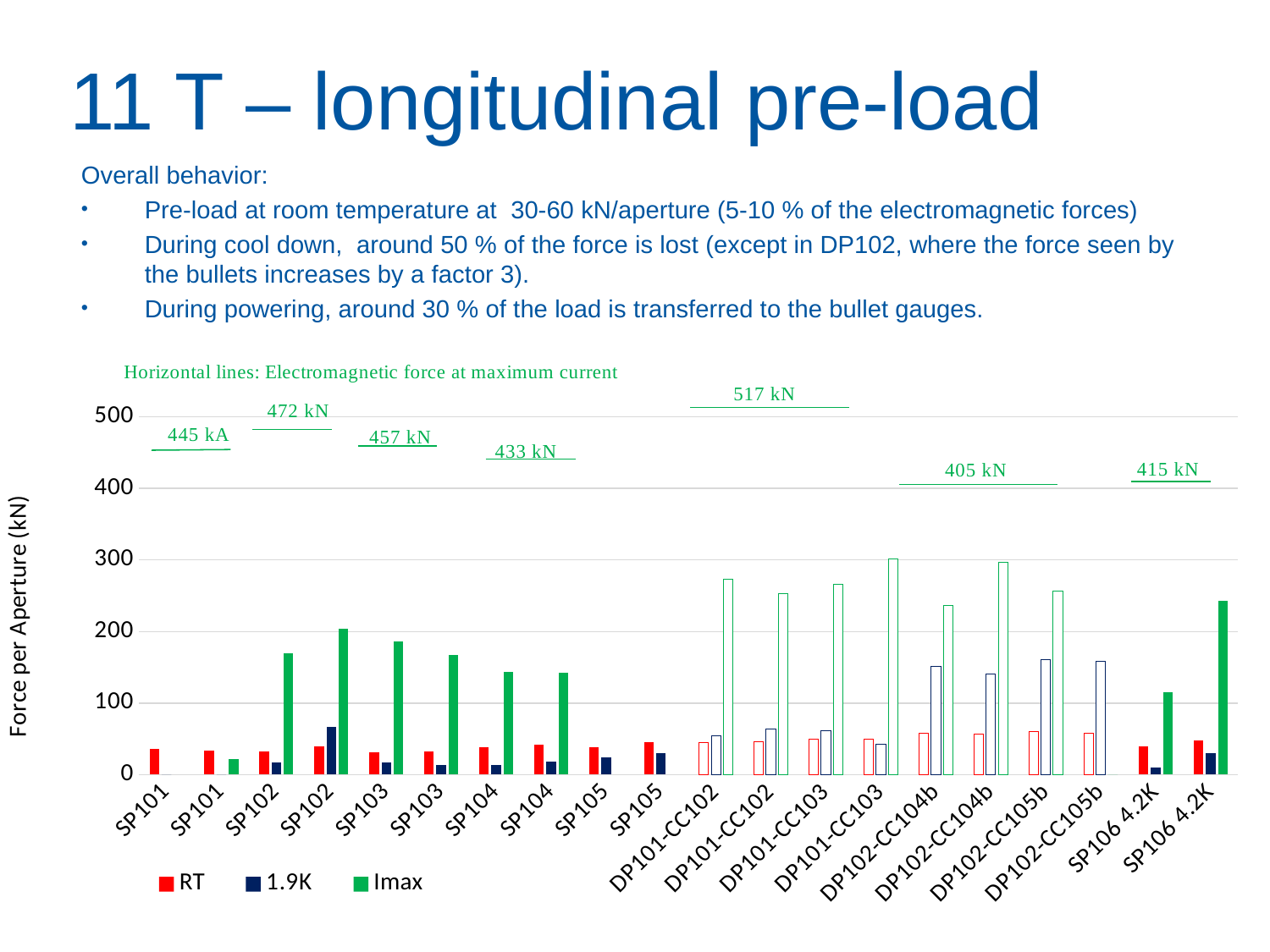
What are the three series named in the chart legend? RT, 1.9K, Imax What electromagnetic force at maximum current is labelled on the horizontal line above DP101-CC102 and DP101-CC103? 517 kN How many series does the chart legend list? 3 Is the Imax value for the first DP101-CC102 group greater or less than 200? greater What is the difference between the horizontal line values labelled 472 kN (SP102) and 433 kN (SP104)? 39 kN Which labelled horizontal line shows the lowest electromagnetic force at maximum current? 405 kN Is the 1.9K value for the second SP102 group greater or less than 100? less How many category groups are shown along the x axis of the chart? 20 What is the title of the vertical axis of the chart? Force per Aperture (kN) What electromagnetic force at maximum current is labelled on the horizontal line above SP102? 472 kN What kind of chart is shown on the slide? bar chart Which labelled horizontal line shows the highest electromagnetic force at maximum current? 517 kN